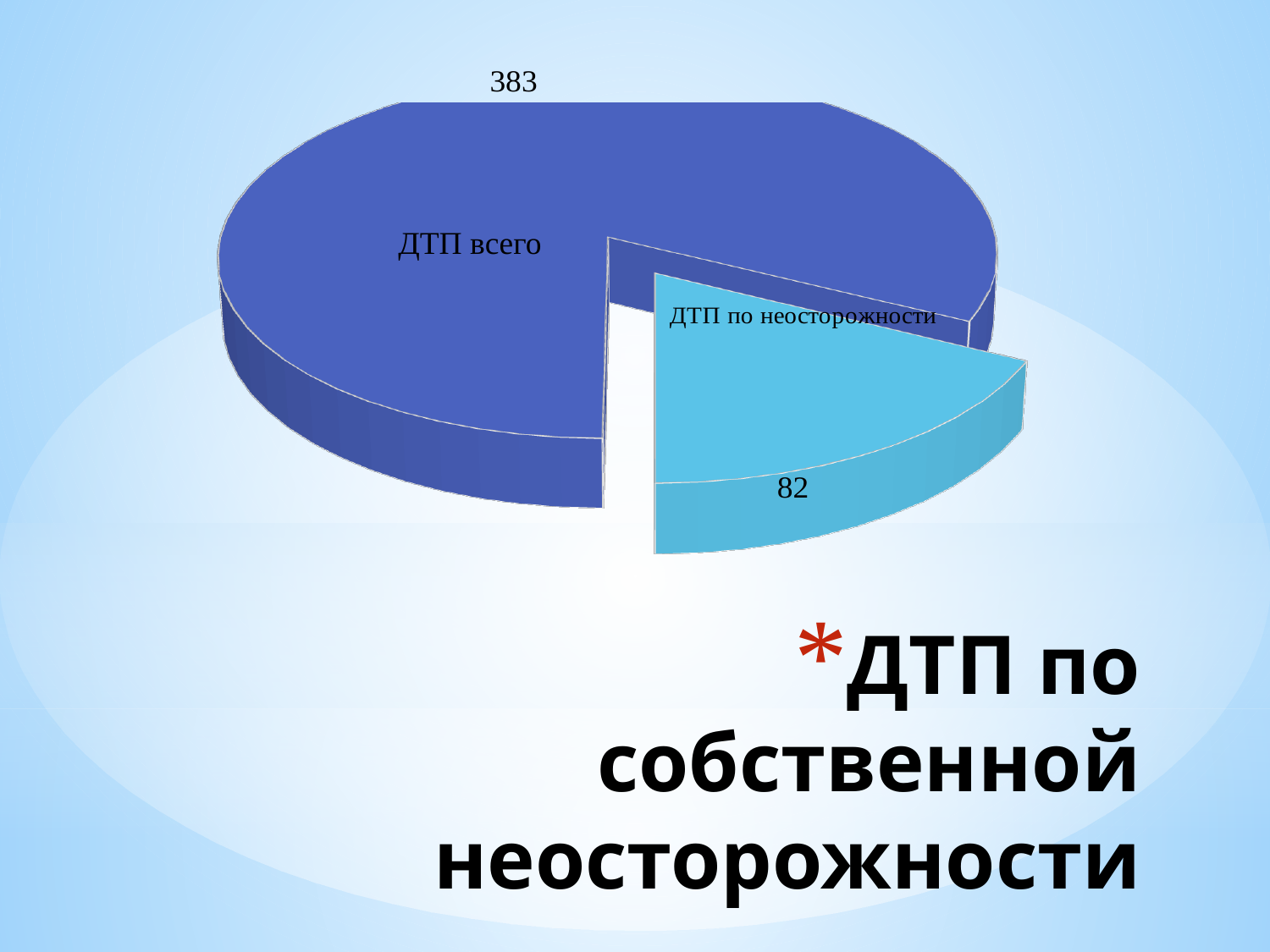
What is the difference between the values of "ДТП всего" and "ДТП по неосторожности"? 301 What value is shown for the "ДТП всего" slice of the pie chart? 383 What type of chart is shown on the slide? Pie chart Which slice of the pie chart is the smallest? ДТП по неосторожности What is the text of the heading printed below the pie chart? ДТП по собственной неосторожности What is the sum of the two values shown on the pie chart? 465 Which is larger: the value for "ДТП всего" or the value for "ДТП по неосторожности"? ДТП всего How many slices does the pie chart have? 2 What colour is the "ДТП по неосторожности" slice of the pie chart? Light blue Which slice of the pie chart is the largest? ДТП всего What value is shown for the "ДТП по неосторожности" slice of the pie chart? 82